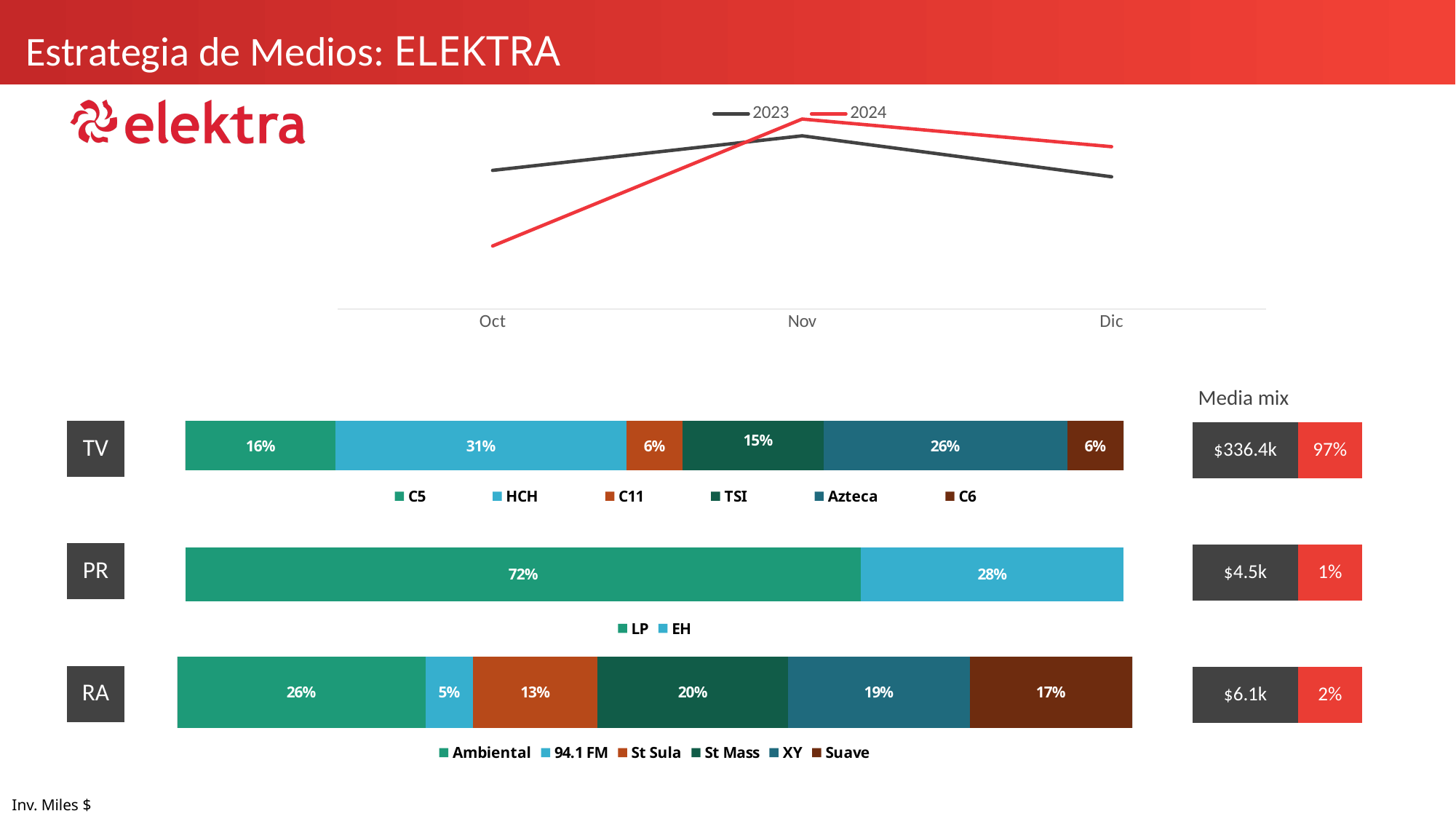
What kind of chart is used for the TV, PR and RA rows? stacked bar chart In the RA bar, which station has the smallest share? 94.1 FM In the TV bar, what is the value for HCH? 31% In the line chart at the top, which series has the higher value in Oct, 2023 or 2024? 2023 In the line chart at the top, which series has the higher value in Dic, 2023 or 2024? 2024 In the TV bar, which channel has the largest share? HCH In the TV bar, what is the difference between HCH and Azteca? 5% In the line chart at the top, in which month does the 2024 line reach its highest point? Nov In the line chart at the top, does the 2024 line rise or fall from Nov to Dic? fall In the line chart at the top, how many series does the legend list? 2 In the PR bar, what is the value for LP? 72% In the line chart at the top, how many months are shown on the x axis? 3